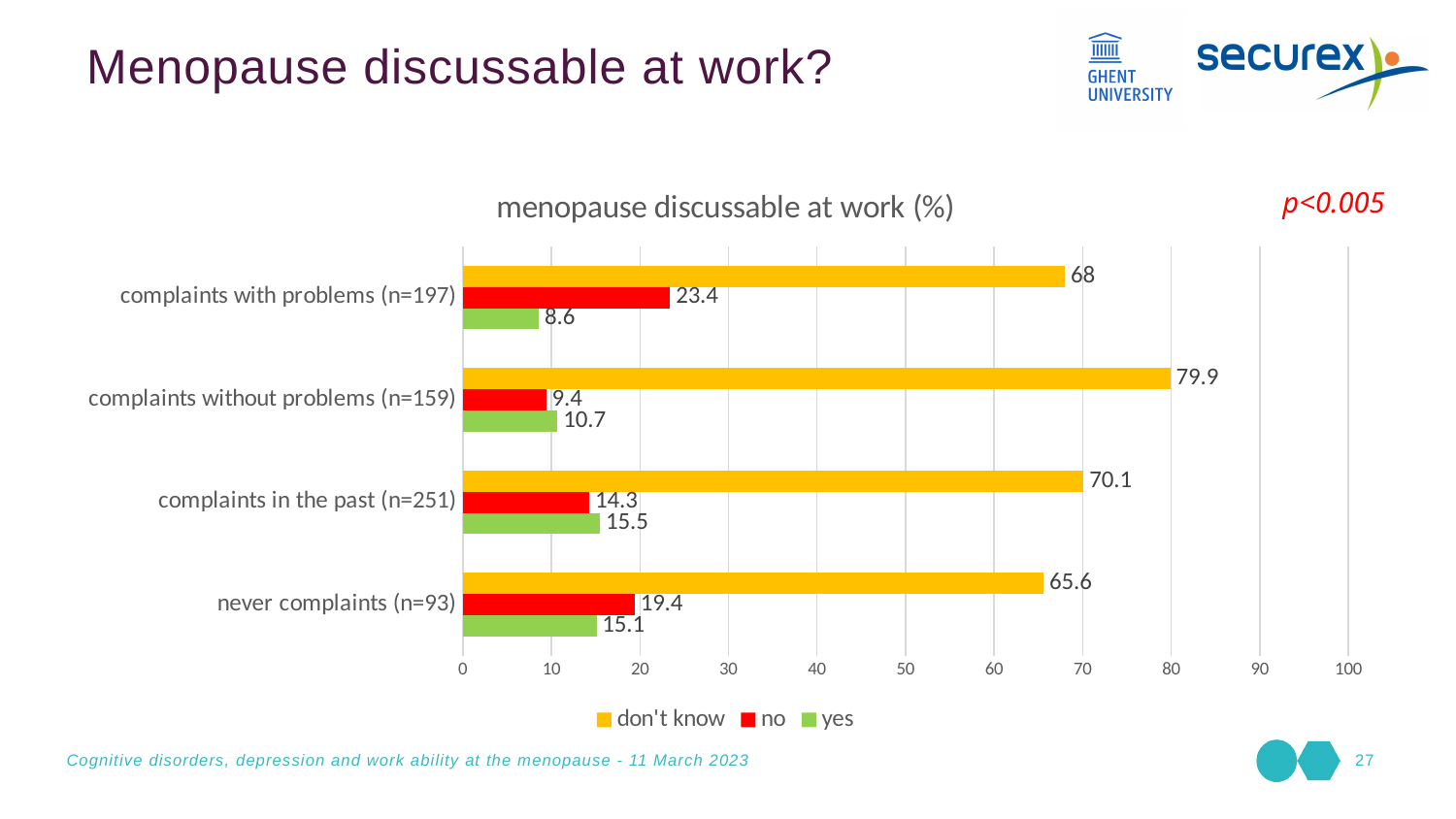
What is the 'no' value for never complaints (n=93)? 19.4 What is the difference between the 'no' values for complaints with problems (n=197) and complaints without problems (n=159)? 14 How many series does the legend list? 3 Which is larger: the 'yes' value for complaints in the past (n=251) or the 'yes' value for never complaints (n=93)? complaints in the past (n=251) What is the title of the chart? menopause discussable at work (%) What is the 'yes' value for complaints with problems (n=197)? 8.6 Which category has the lowest 'yes' value? complaints with problems (n=197) What kind of chart is shown? bar chart How many categories are shown on the y axis? 4 What is the 'don't know' value for complaints without problems (n=159)? 79.9 Is the 'don't know' value for never complaints (n=93) greater or less than 60? greater Which category has the highest 'don't know' value? complaints without problems (n=159)